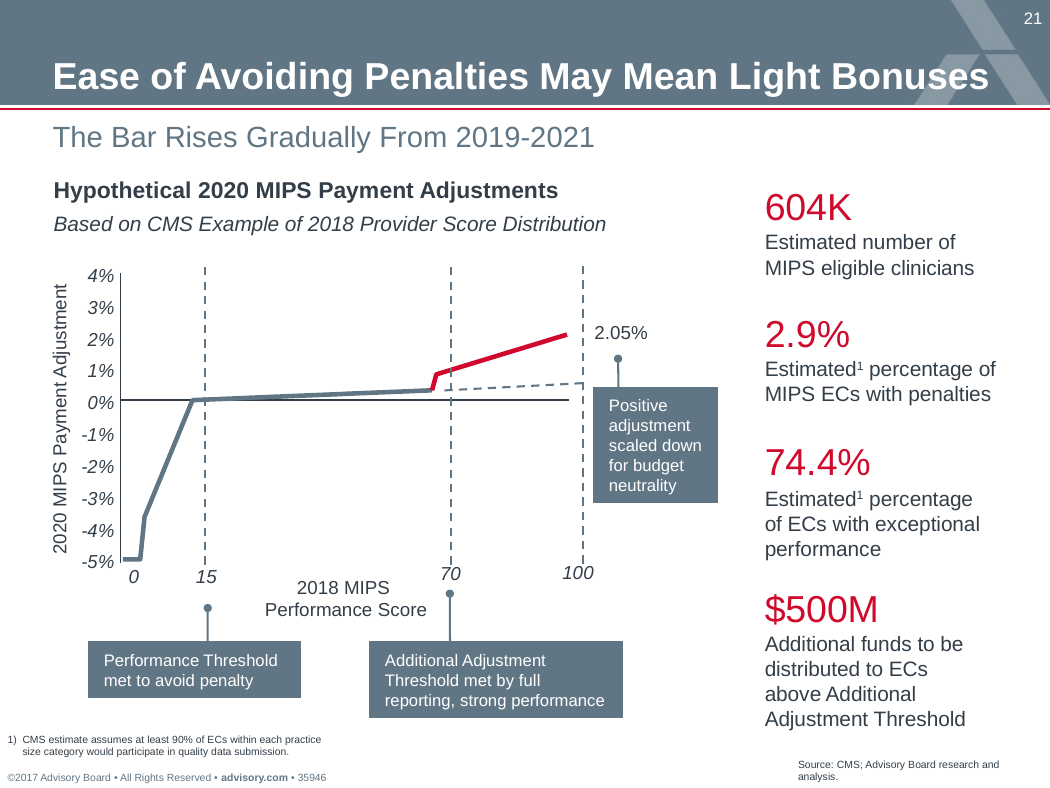
Does the 2020 MIPS payment adjustment rise or fall as the 2018 MIPS performance score increases? rises What kind of chart is shown on the slide? line chart What is the 2020 MIPS payment adjustment at a 2018 MIPS performance score of 0? -5% Is the payment adjustment at a performance score of 70 greater or less than 2%? less At which 2018 MIPS performance score is the payment adjustment lowest? 0 What is the 2020 MIPS payment adjustment at a 2018 MIPS performance score of 100? 2.05% What is the 2020 MIPS payment adjustment at a 2018 MIPS performance score of 15? 0% Is the payment adjustment at a performance score of 100 greater or less than 1%? greater How many tick values are labeled on the x axis of the chart? 4 What is the title of the chart? Hypothetical 2020 MIPS Payment Adjustments What is the label of the x axis of the chart? 2018 MIPS Performance Score At which 2018 MIPS performance score is the payment adjustment highest? 100